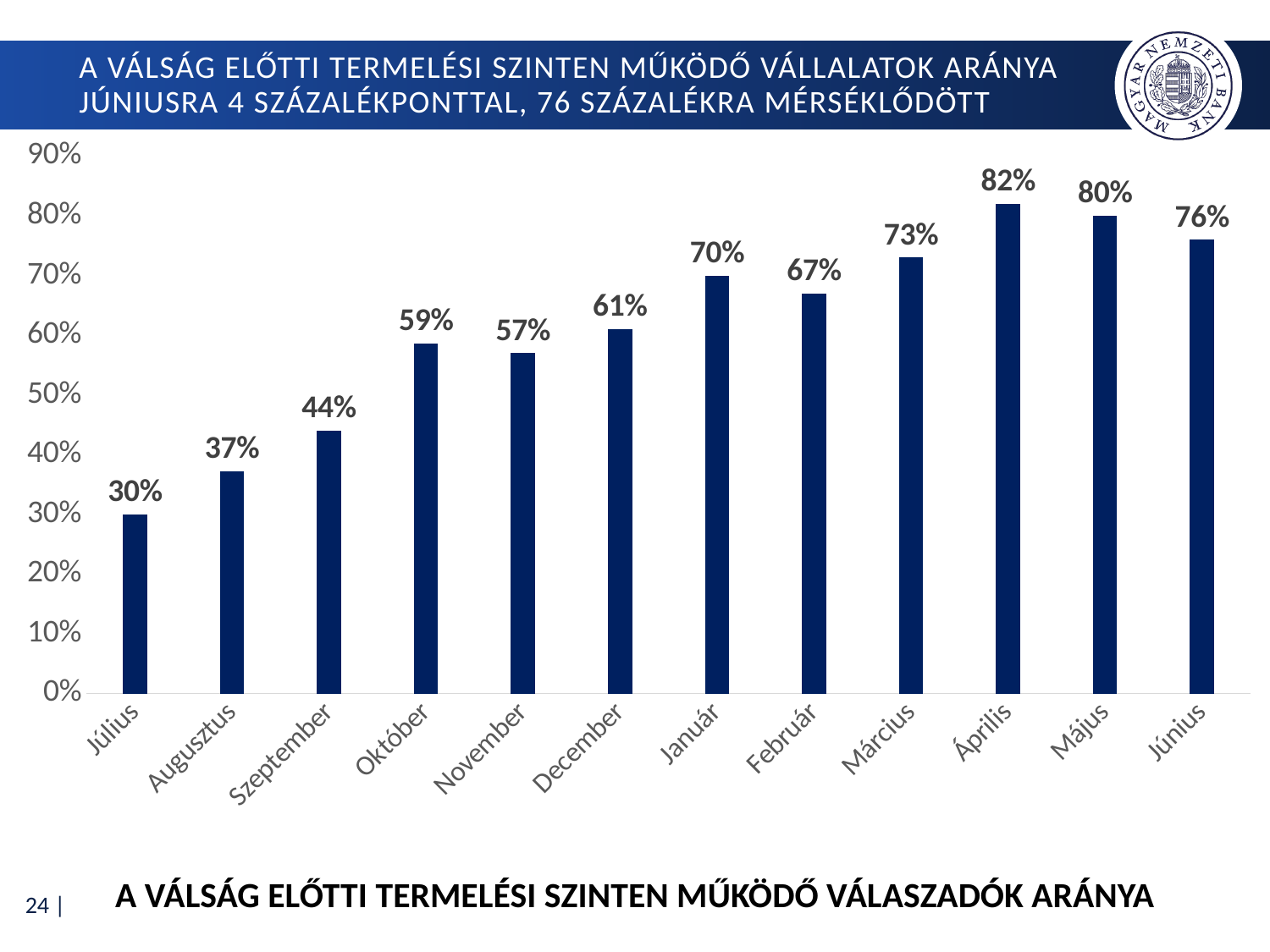
What is the difference between the values for Július and Augusztus? 7 percentage points Do the values generally rise or fall from Július to Április? Rise Which is larger, the value for November or the value for December? December What is the difference between the values for Április and Június? 6 percentage points Is the value for Január greater or less than 60%? greater What is the value for Október? 59% What is the value for Június? 76% How many months are shown on the x axis? 12 What kind of chart is shown on the slide? Bar chart Which month has the lowest value? Július What is the value for Február? 67% Which month has the highest value? Április